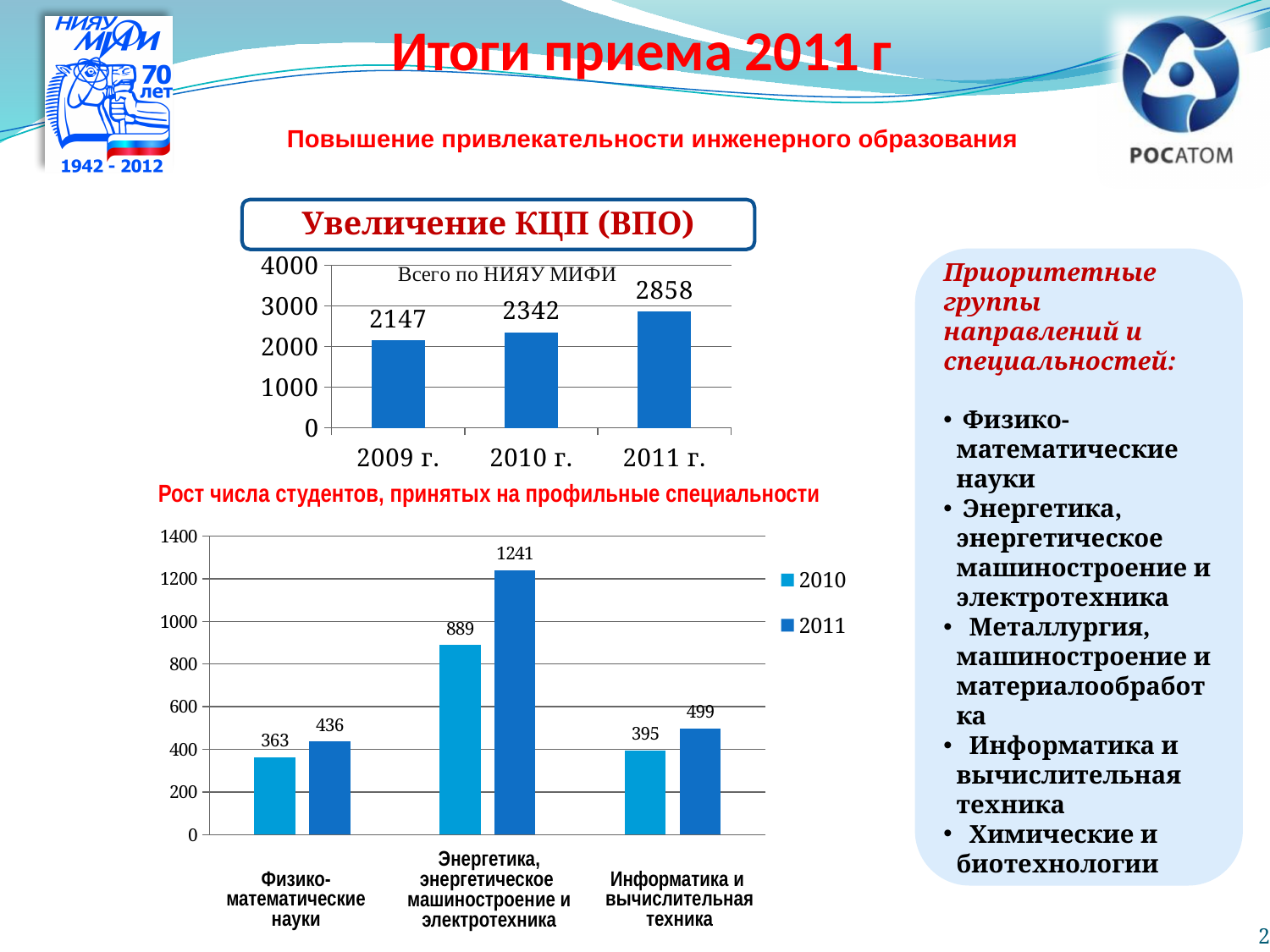
In the top chart 'Всего по НИЯУ МИФИ', what is the value for 2011 г.? 2858 In the bottom chart 'Рост числа студентов, принятых на профильные специальности', what is the 2010 value for Информатика и вычислительная техника? 395 In the top chart 'Всего по НИЯУ МИФИ', what is the value for 2009 г.? 2147 In the top chart 'Всего по НИЯУ МИФИ', do the values rise or fall from 2009 г. to 2011 г.? rise In the top chart 'Всего по НИЯУ МИФИ', which year has the lowest value? 2009 г. In the bottom chart 'Рост числа студентов, принятых на профильные специальности', how many series does the legend list? 2 In the bottom chart 'Рост числа студентов, принятых на профильные специальности', what is the difference between the 2011 and 2010 values for Физико-математические науки? 73 In the top chart 'Всего по НИЯУ МИФИ', what is the difference between the 2011 г. and 2010 г. values? 516 In the top chart 'Всего по НИЯУ МИФИ', how many years are shown? 3 In the bottom chart 'Рост числа студентов, принятых на профильные специальности', what is the 2011 value for Энергетика, энергетическое машиностроение и электротехника? 1241 In the bottom chart 'Рост числа студентов, принятых на профильные специальности', which category has the highest 2011 value? Энергетика, энергетическое машиностроение и электротехника What type of chart is the bottom chart 'Рост числа студентов, принятых на профильные специальности'? bar chart